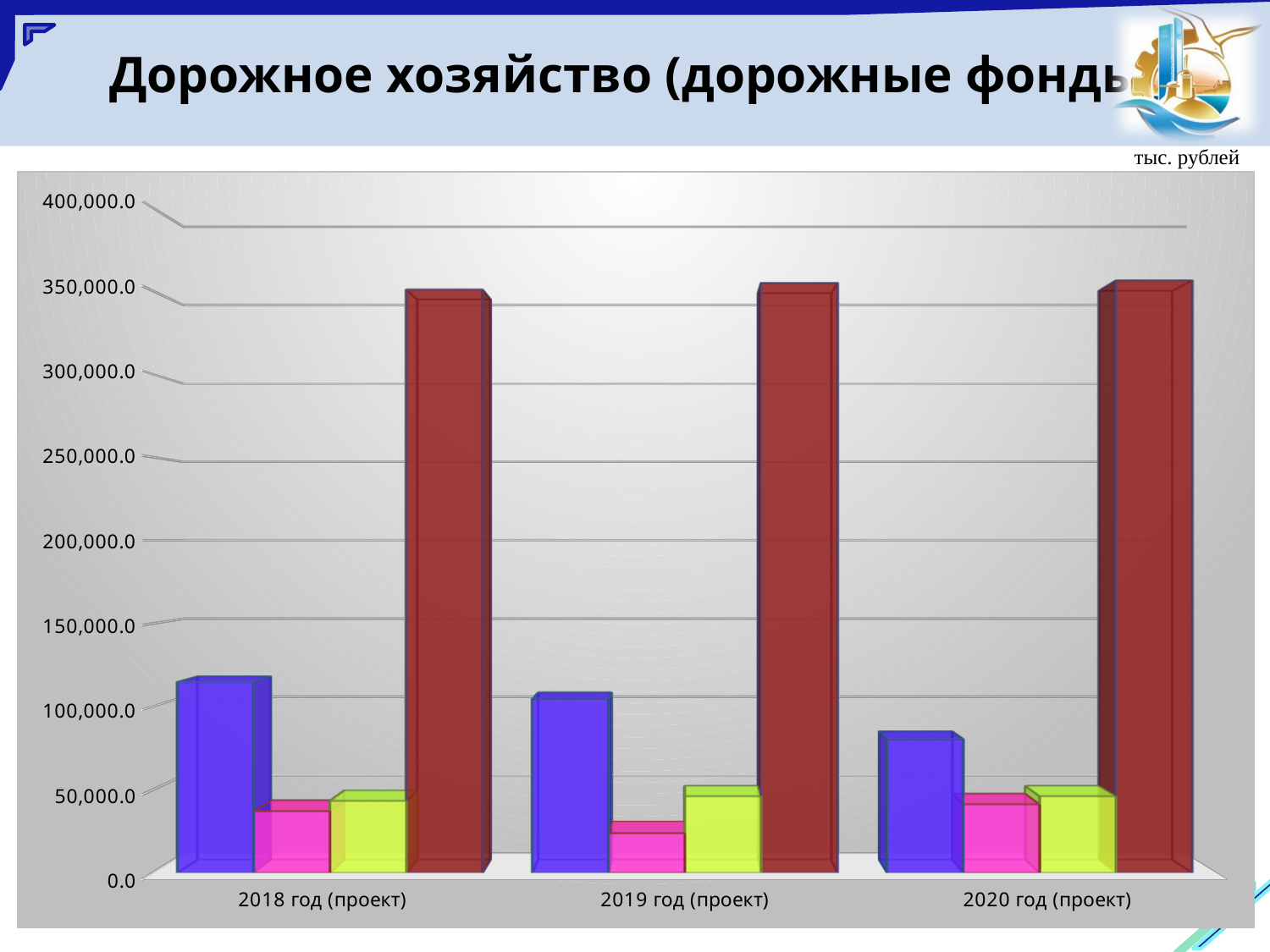
What unit is indicated above the chart? тыс. рублей Is the value of the pink bar for 2019 год (проект) greater or less than 50,000.0? less Is the value of the dark red bar for 2019 год (проект) greater or less than 300,000.0? greater What is the title of the slide containing the chart? Дорожное хозяйство (дорожные фонды) Is the value of the blue bar for 2018 год (проект) greater or less than 100,000.0? greater How many categories are shown along the x axis of the chart? 3 Which is larger: the blue bar for 2018 год (проект) or the blue bar for 2020 год (проект)? 2018 год (проект) How many bars are plotted for each year category in the chart? 4 What kind of chart is shown on the slide? bar chart Do the values of the blue bars rise or fall from 2018 год (проект) to 2020 год (проект)? fall Which coloured bar is the lowest in the 2019 год (проект) group? pink